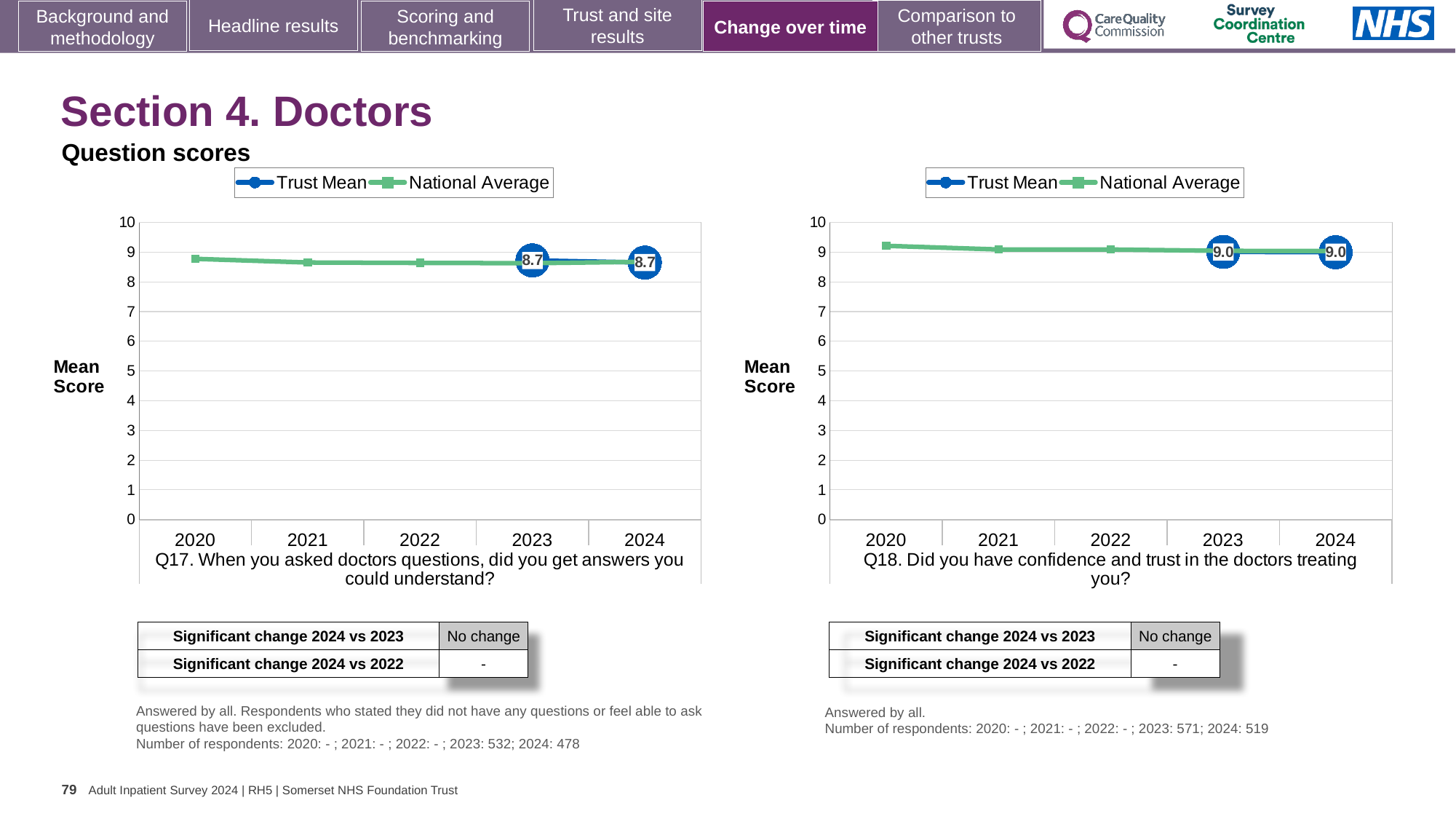
How many series does the legend of the Q17 chart list? 2 How many years are shown on the x axis of the Q18 chart? 5 In the Q17 chart, what is the difference between the Trust Mean values for 2024 and 2023? 0 In the Q17 chart, what is the Trust Mean value for 2023? 8.7 In the Q18 chart, what is the Trust Mean value for 2023? 9.0 In the Q18 chart, what is the Trust Mean value for 2024? 9.0 In the Q18 chart, is the National Average value for 2020 greater or less than 8? greater In the Q18 chart, what is the difference between the Trust Mean values for 2024 and 2023? 0 In the Q17 chart, is the National Average value for 2020 greater or less than 8? greater In the Q17 chart, what is the Trust Mean value for 2024? 8.7 What kind of chart is the Q17 chart? Line chart What are the two series named in the legend of the Q18 chart? Trust Mean and National Average